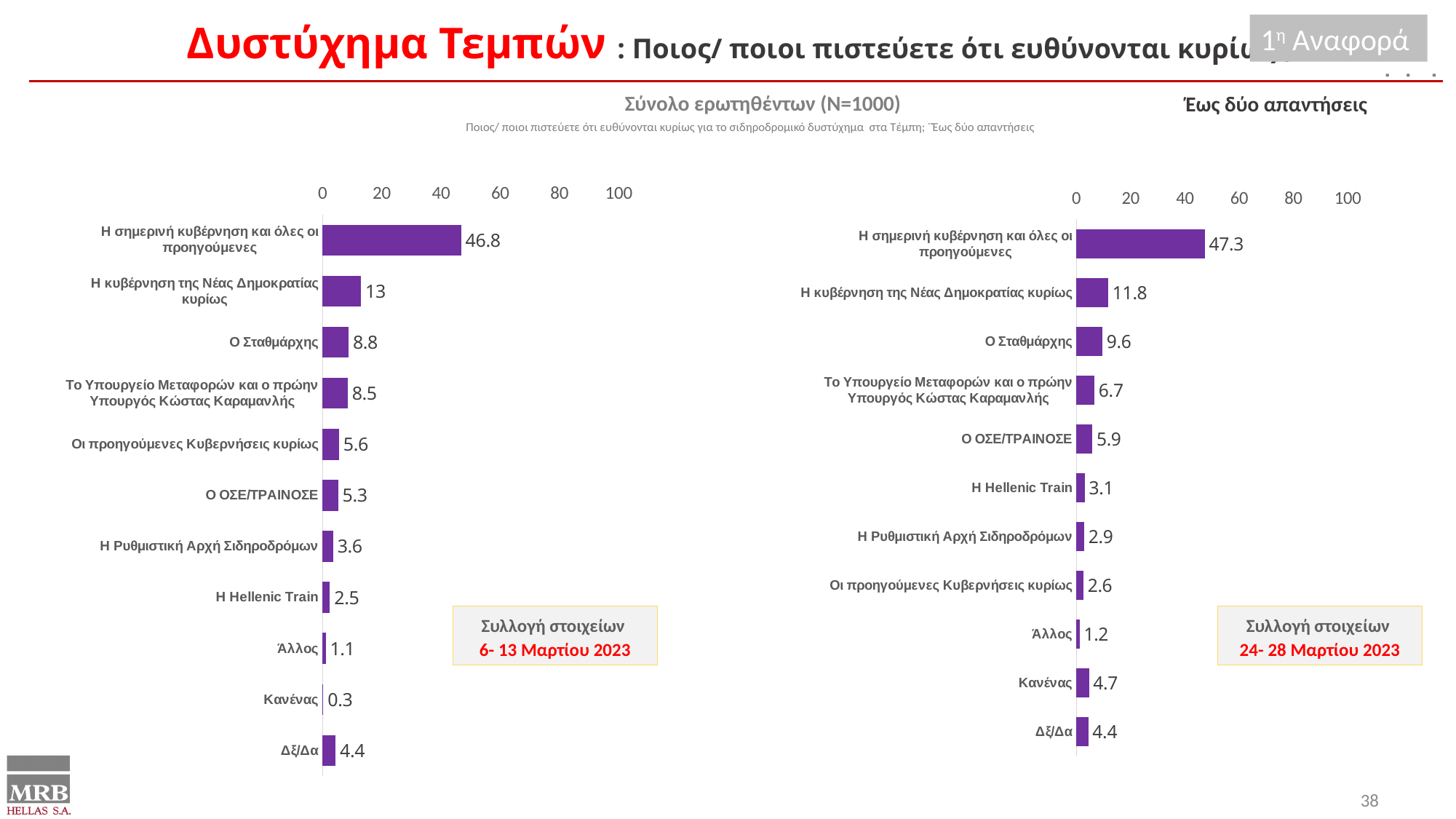
In the left chart (6-13 Μαρτίου 2023), which is larger: 'Οι προηγούμενες Κυβερνήσεις κυρίως' or 'Ο ΟΣΕ/ΤΡΑΙΝΟΣΕ'? Οι προηγούμενες Κυβερνήσεις κυρίως In the right chart (24-28 Μαρτίου 2023), which category has the lowest value? Άλλος In the left chart (6-13 Μαρτίου 2023), what is the difference between 'Η κυβέρνηση της Νέας Δημοκρατίας κυρίως' and 'Ο Σταθμάρχης'? 4.2 How many categories are shown in the left chart (6-13 Μαρτίου 2023)? 11 In the right chart (24-28 Μαρτίου 2023), which category has the highest value? Η σημερινή κυβέρνηση και όλες οι προηγούμενες In the right chart (24-28 Μαρτίου 2023), what is the difference between 'Η σημερινή κυβέρνηση και όλες οι προηγούμενες' and 'Η κυβέρνηση της Νέας Δημοκρατίας κυρίως'? 35.5 What type of chart is the right chart (24-28 Μαρτίου 2023)? Bar chart In the left chart (6-13 Μαρτίου 2023), what is the value for 'Η σημερινή κυβέρνηση και όλες οι προηγούμενες'? 46.8 In the left chart (6-13 Μαρτίου 2023), what is the value for 'Η Hellenic Train'? 2.5 In the right chart (24-28 Μαρτίου 2023), what is the value for 'Ο Σταθμάρχης'? 9.6 In the left chart (6-13 Μαρτίου 2023), which category has the lowest value? Κανένας In the right chart (24-28 Μαρτίου 2023), is the value for 'Η σημερινή κυβέρνηση και όλες οι προηγούμενες' greater or less than 40? greater